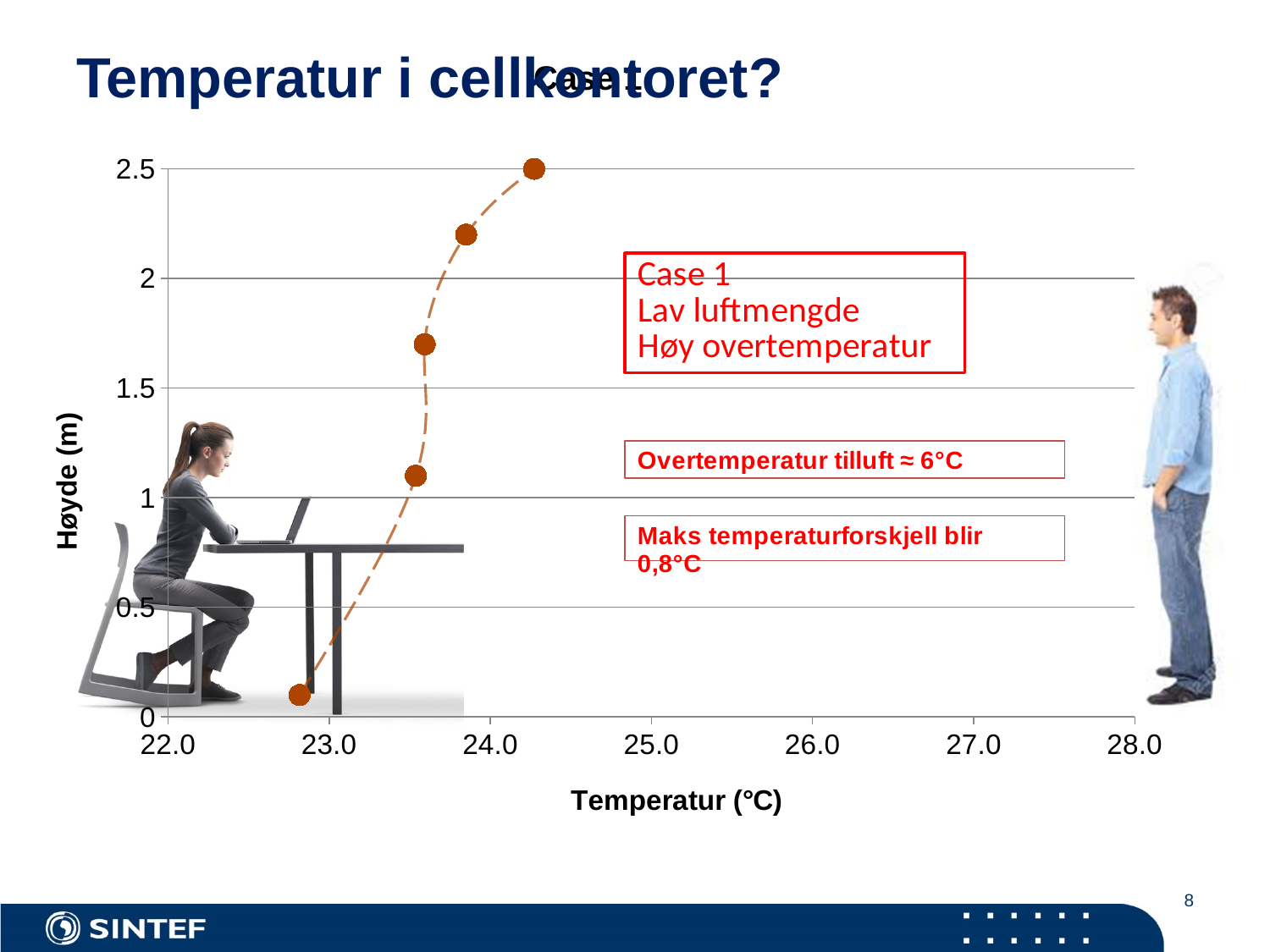
How many data points are plotted on the chart? 5 What is the maximum value shown on the vertical height axis? 2.5 What is the title of the vertical axis of the chart? Høyde (m) What kind of chart is shown on the slide? scatter chart with a dashed line Is the temperature of the highest plotted point (at about 2.5 m) greater or less than 24.0? greater Is the temperature of the lowest plotted point (near 0 m height) greater or less than 23.0? less Is the temperature of the point at about 1 m height greater or less than 24.0? less Does the temperature increase or decrease as the height increases along the curve? increase What is the maximum value shown on the horizontal temperature axis? 28.0 Which plotted point has the highest temperature: the one at the top of the curve (about 2.5 m) or the one at the bottom (near 0 m)? the one at the top (about 2.5 m)